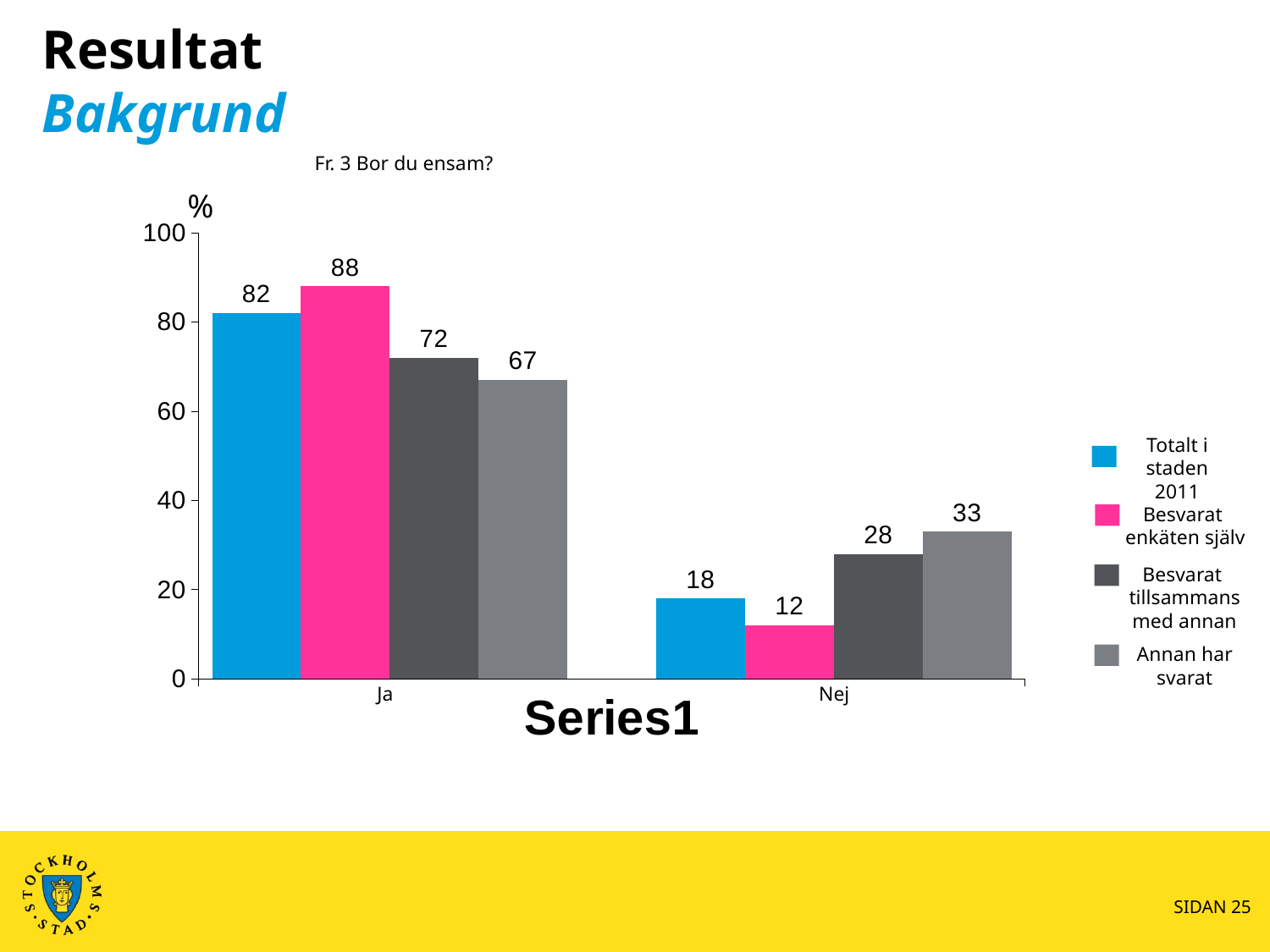
What is the value for 'Besvarat tillsammans med annan' in the 'Nej' category? 28 How many series does the legend list? 4 What is the value for 'Annan har svarat' in the 'Ja' category? 67 What is the title of the chart? Fr. 3 Bor du ensam? Which series has the lowest value in the 'Nej' category? Besvarat enkäten själv What is the value for 'Totalt i staden 2011' in the 'Ja' category? 82 What kind of chart is shown on the slide? Bar chart Which series has the highest value in the 'Ja' category? Besvarat enkäten själv How many categories are shown on the x axis? 2 Which is larger in the 'Nej' category: 'Totalt i staden 2011' or 'Annan har svarat'? Annan har svarat What is the difference between 'Besvarat enkäten själv' and 'Annan har svarat' in the 'Ja' category? 21 What is the value for 'Besvarat enkäten själv' in the 'Nej' category? 12